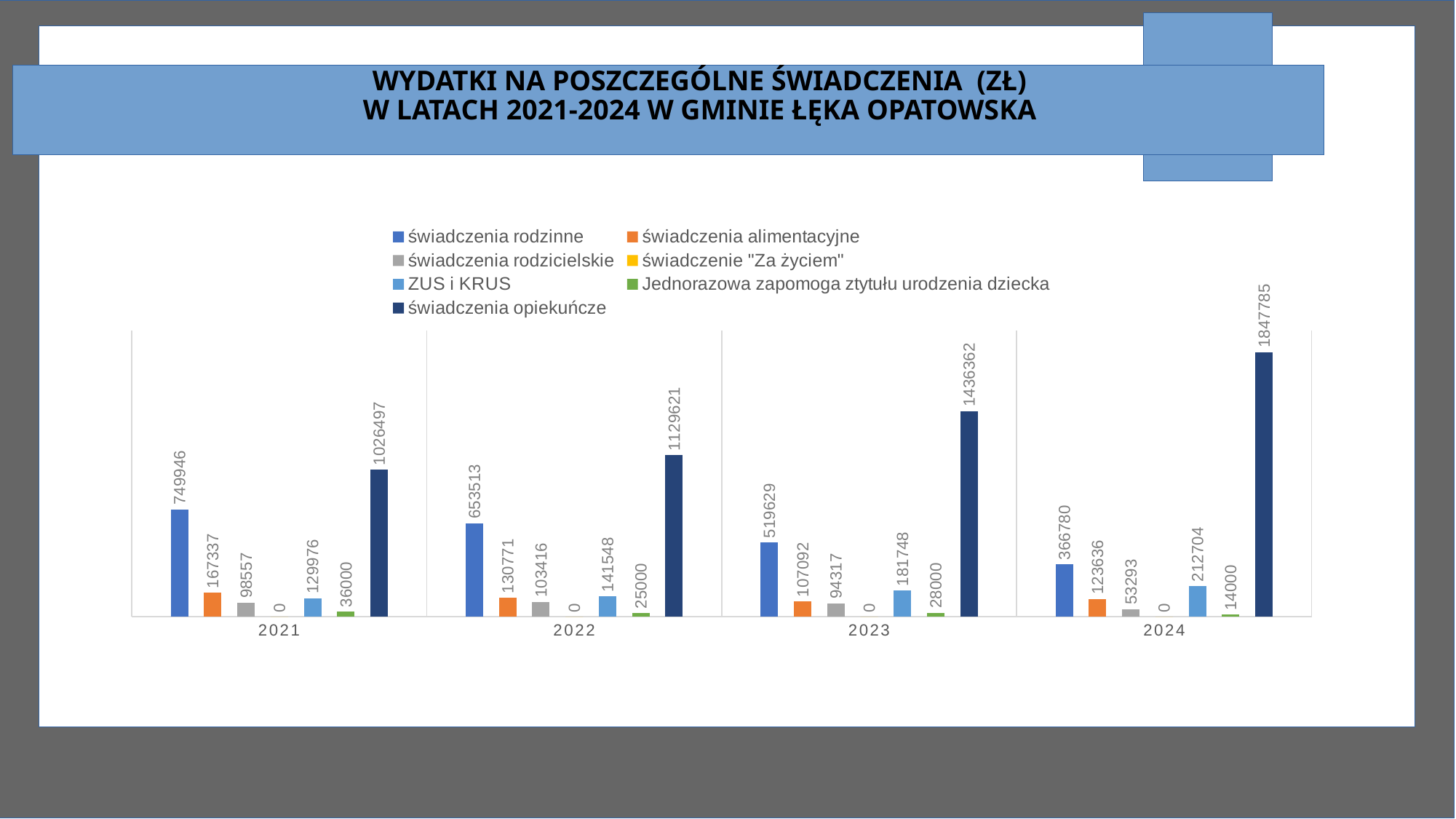
How many series does the legend list? 7 What is the value for świadczenie "Za życiem" in 2022? 0 What type of chart is shown on the slide? bar chart In which year is the value for świadczenia rodzinne lowest? 2024 What is the value for świadczenia rodzinne in 2021? 749946 In which year is the value for świadczenia opiekuńcze highest? 2024 What is the value for ZUS i KRUS in 2023? 181748 What is the difference between świadczenia opiekuńcze in 2024 and in 2021? 821288 Which is larger: świadczenia alimentacyjne in 2021 or ZUS i KRUS in 2021? świadczenia alimentacyjne in 2021 Do the values for świadczenia rodzinne rise or fall from 2021 to 2024? fall What is the value for świadczenia opiekuńcze in 2024? 1847785 How many years are shown on the x axis? 4